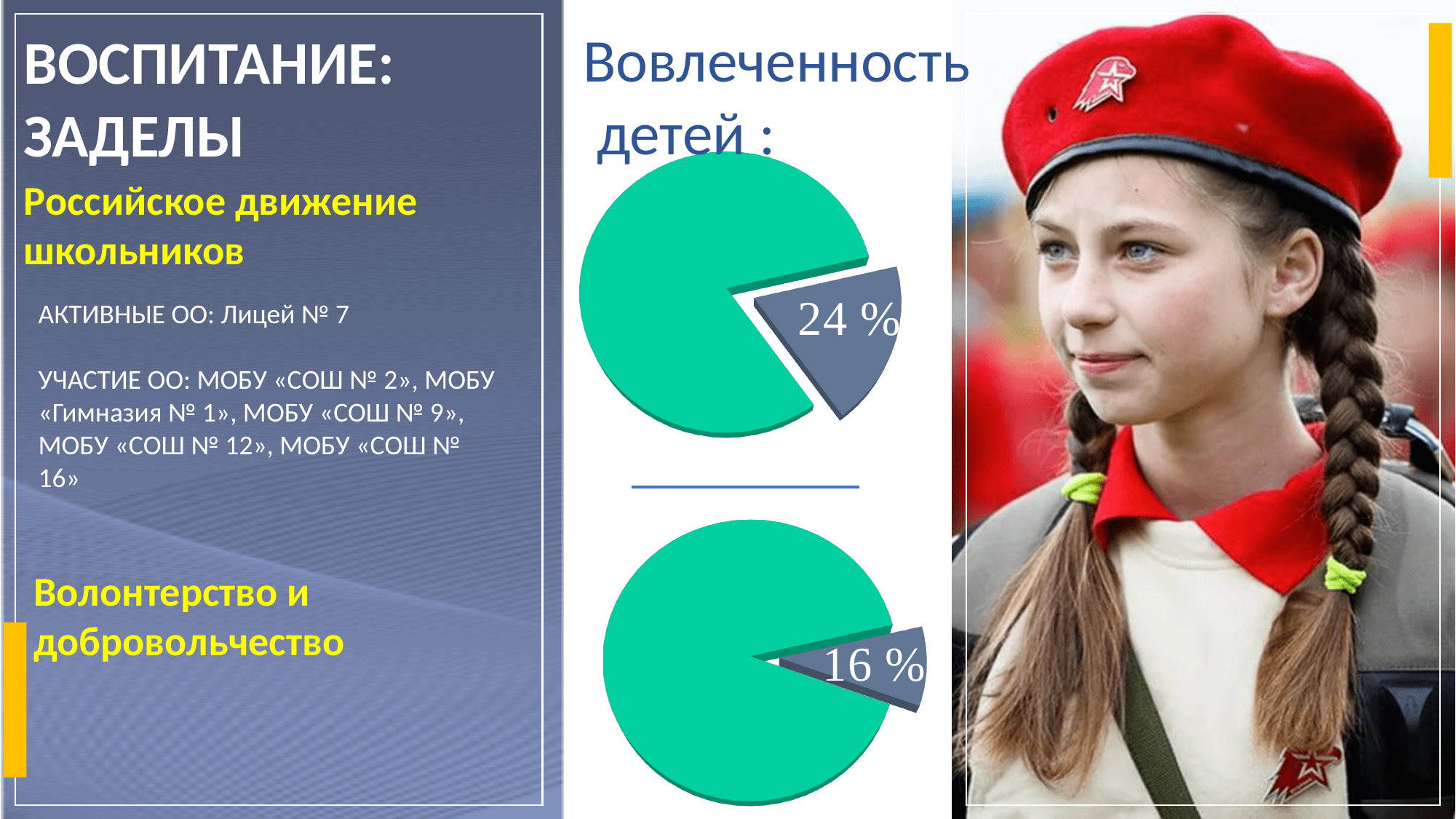
In the top pie chart, which slice is larger: the green slice or the dark blue-grey slice? The green slice In the bottom pie chart, which slice is smaller: the green slice or the dark blue-grey slice? The dark blue-grey slice What heading is printed above the two pie charts? Вовлеченность детей : How many slices does the top pie chart have? 2 How many slices does the bottom pie chart have? 2 Which labelled slice is larger: the 24 % slice in the top pie chart or the 16 % slice in the bottom pie chart? The 24 % slice in the top pie chart What is the difference between the labelled slice of the top pie chart and the labelled slice of the bottom pie chart? 8 % What kind of chart is the top chart on the slide? Pie chart In the top pie chart, what value is printed on the exploded dark blue-grey slice? 24 % What kind of chart is the bottom chart on the slide? Pie chart In the bottom pie chart, what value is printed on the exploded dark blue-grey slice? 16 % What colour is the largest slice in the bottom pie chart? Green